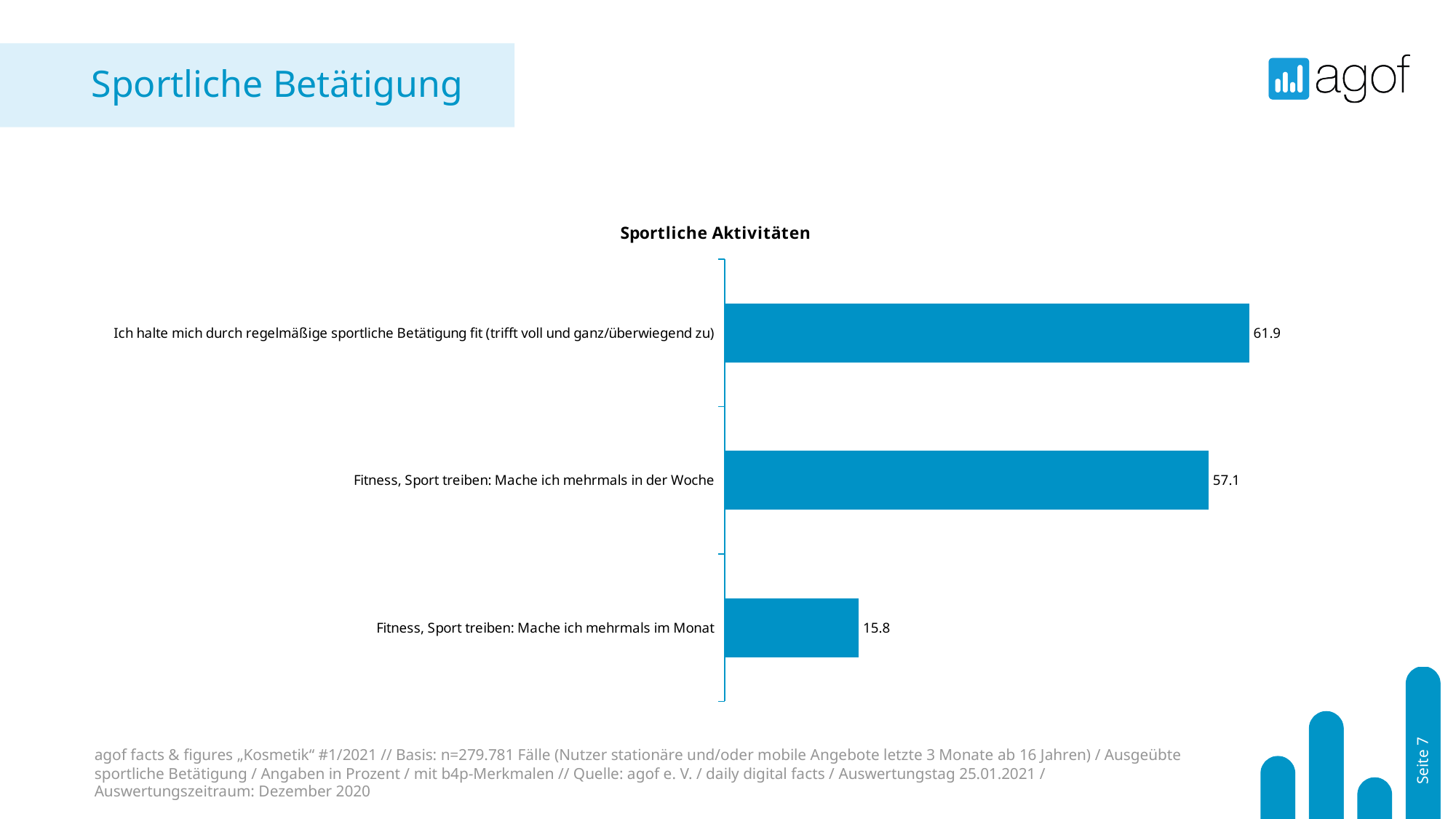
What is the value for "Fitness, Sport treiben: Mache ich mehrmals in der Woche"? 57.1 What is the difference between the values for "Fitness, Sport treiben: Mache ich mehrmals in der Woche" and "Fitness, Sport treiben: Mache ich mehrmals im Monat"? 41.3 Which is larger: the value for "Fitness, Sport treiben: Mache ich mehrmals in der Woche" or for "Fitness, Sport treiben: Mache ich mehrmals im Monat"? Fitness, Sport treiben: Mache ich mehrmals in der Woche How many categories are shown in the chart? 3 Which category has the lowest value? Fitness, Sport treiben: Mache ich mehrmals im Monat What is the title of the chart? Sportliche Aktivitäten What is the value for "Ich halte mich durch regelmäßige sportliche Betätigung fit (trifft voll und ganz/überwiegend zu)"? 61.9 What kind of chart is shown on the slide? Bar chart Which category has the highest value? Ich halte mich durch regelmäßige sportliche Betätigung fit (trifft voll und ganz/überwiegend zu) What is the difference between the values for "Ich halte mich durch regelmäßige sportliche Betätigung fit (trifft voll und ganz/überwiegend zu)" and "Fitness, Sport treiben: Mache ich mehrmals in der Woche"? 4.8 What colour are the bars in the chart? Blue What is the value for "Fitness, Sport treiben: Mache ich mehrmals im Monat"? 15.8